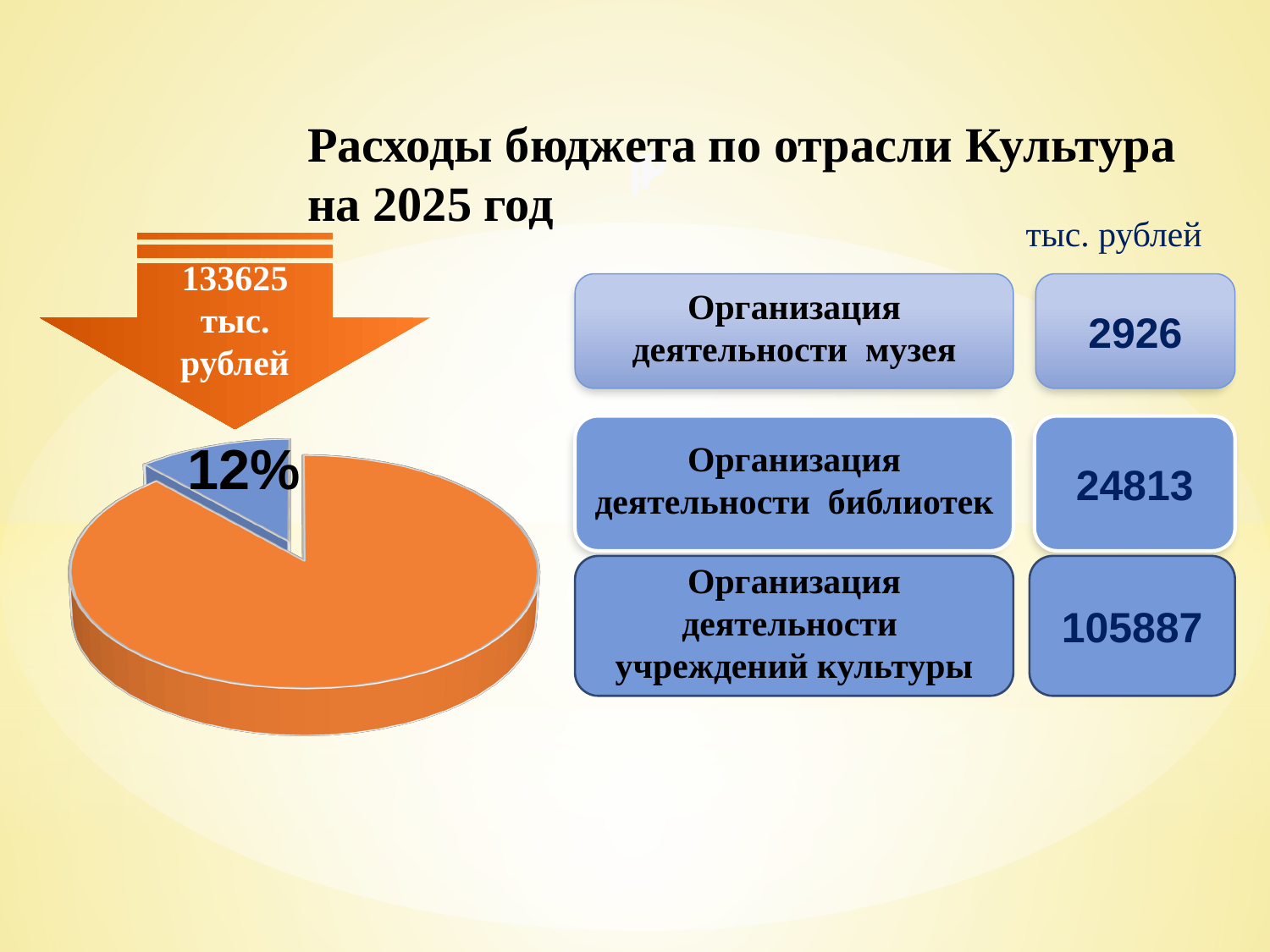
What kind of chart is shown on the left of the slide? pie chart Which slice of the pie chart is larger, the orange one or the blue one? orange Which slice of the pie chart is the smallest? the blue slice (12%) What colour is the largest slice of the pie chart? orange What percentage is printed on the small blue slice of the pie chart? 12% Is the blue slice of the pie chart greater or less than 50% of the pie? less How many slices does the pie chart have? 2